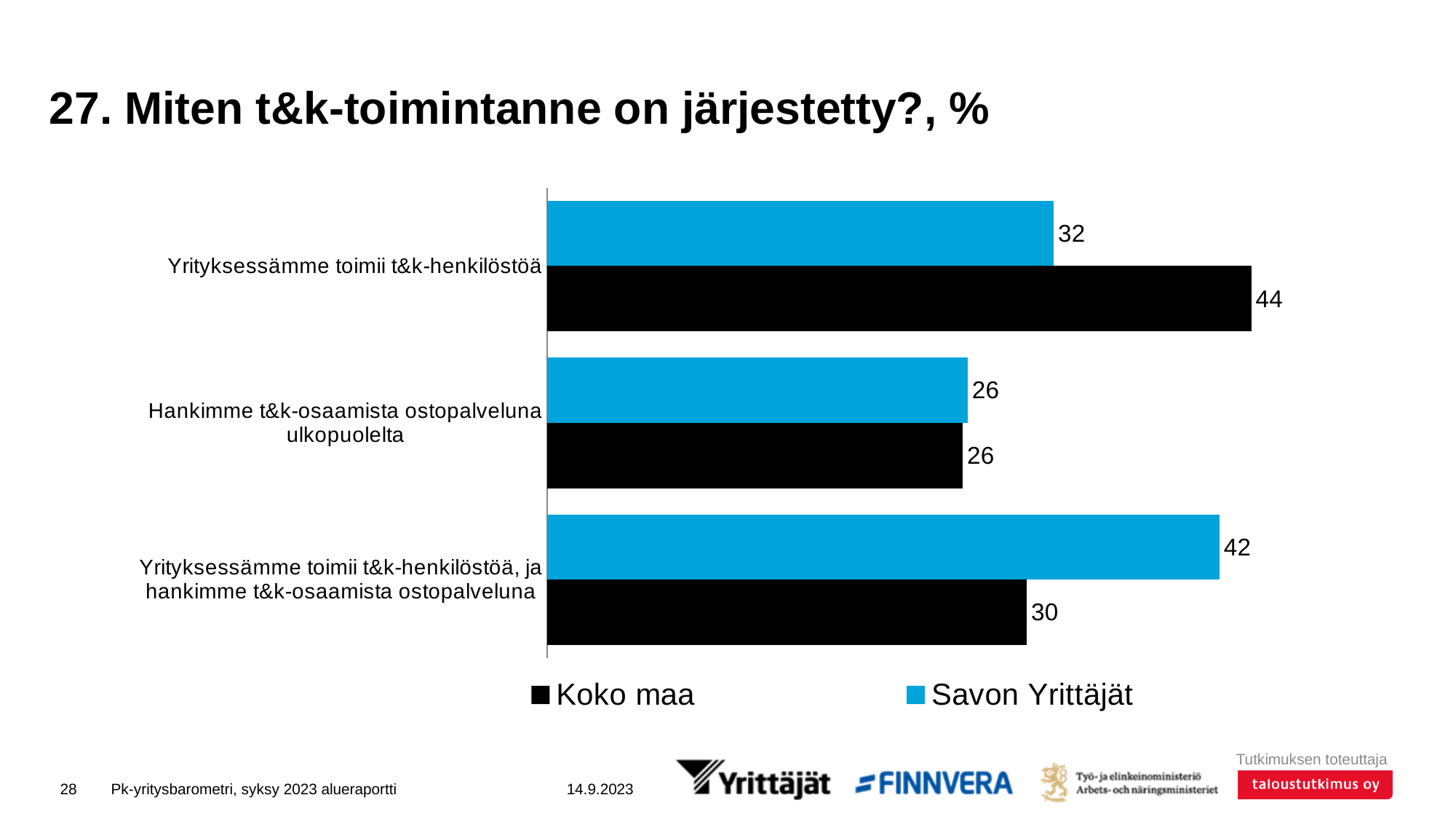
What is the value for Savon Yrittäjät for "Yrityksessämme toimii t&k-henkilöstöä"? 32 What is the difference between Savon Yrittäjät and Koko maa for "Yrityksessämme toimii t&k-henkilöstöä, ja hankimme t&k-osaamista ostopalveluna"? 12 Which category has the lowest value for Savon Yrittäjät? Hankimme t&k-osaamista ostopalveluna ulkopuolelta What is the value for Koko maa for "Hankimme t&k-osaamista ostopalveluna ulkopuolelta"? 26 What is the value for Koko maa for "Yrityksessämme toimii t&k-henkilöstöä"? 44 Which category has the highest value for Koko maa? Yrityksessämme toimii t&k-henkilöstöä How many series does the legend list? 2 How many categories are shown on the chart? 3 What is the difference between Koko maa and Savon Yrittäjät for "Yrityksessämme toimii t&k-henkilöstöä"? 12 What is the value for Savon Yrittäjät for "Yrityksessämme toimii t&k-henkilöstöä, ja hankimme t&k-osaamista ostopalveluna"? 42 For "Yrityksessämme toimii t&k-henkilöstöä, ja hankimme t&k-osaamista ostopalveluna", which series has the larger value, Koko maa or Savon Yrittäjät? Savon Yrittäjät What kind of chart is shown on the slide? Bar chart